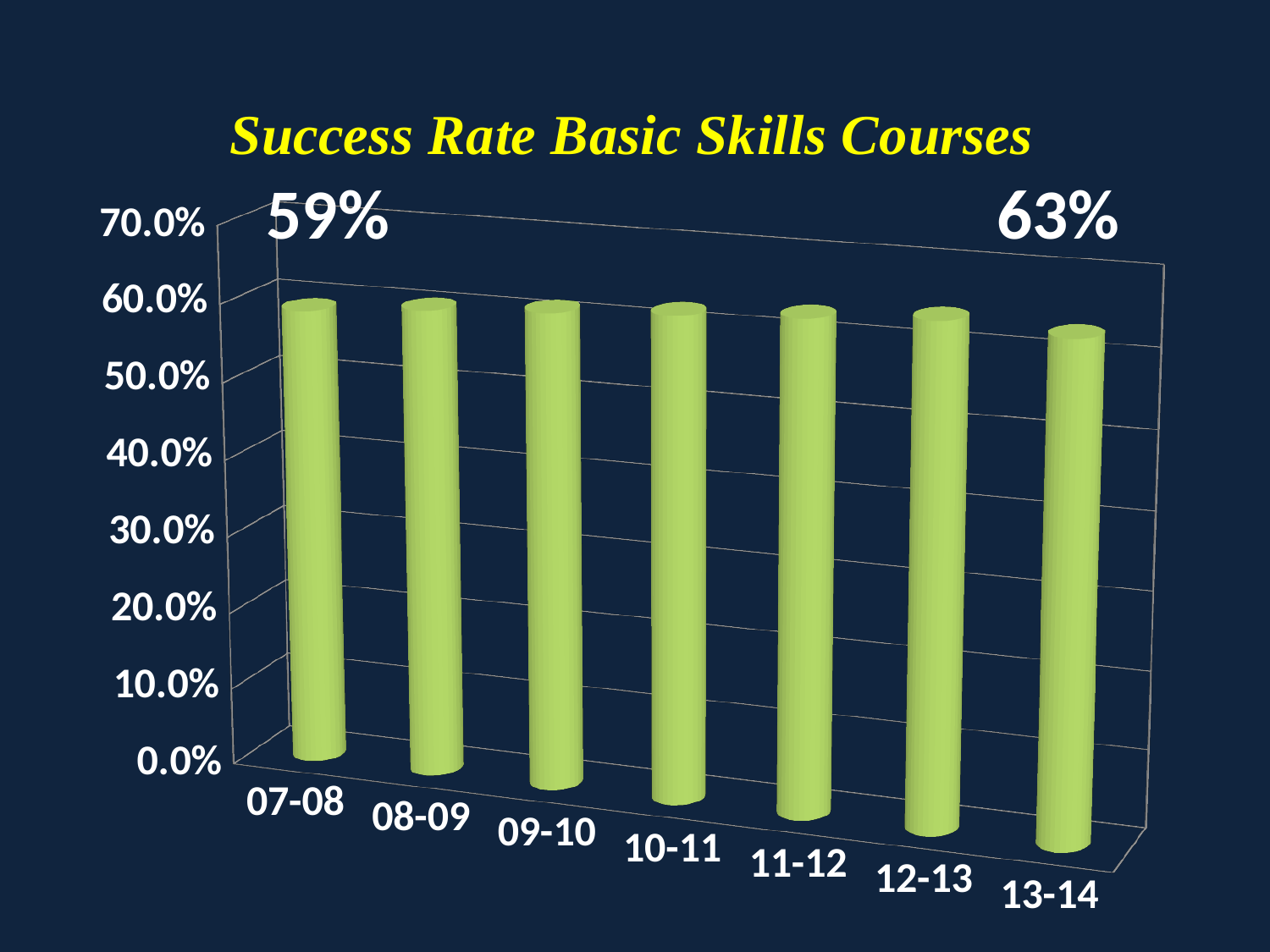
What is the title of the chart? Success Rate Basic Skills Courses What success rate is printed above the 07-08 bar? 59% What is the first category label on the x axis? 07-08 What is the highest value shown on the y axis? 70.0% How many academic years are shown on the x axis of the chart? 7 Is the value for 08-09 greater or less than 30.0%? greater What success rate is printed above the 13-14 bar? 63% Is the value for 11-12 greater or less than 70.0%? less What is the difference between the 63% printed for 13-14 and the 59% printed for 07-08? 4% Is the value for 10-11 greater or less than 40.0%? greater What kind of chart is shown on the slide? bar chart